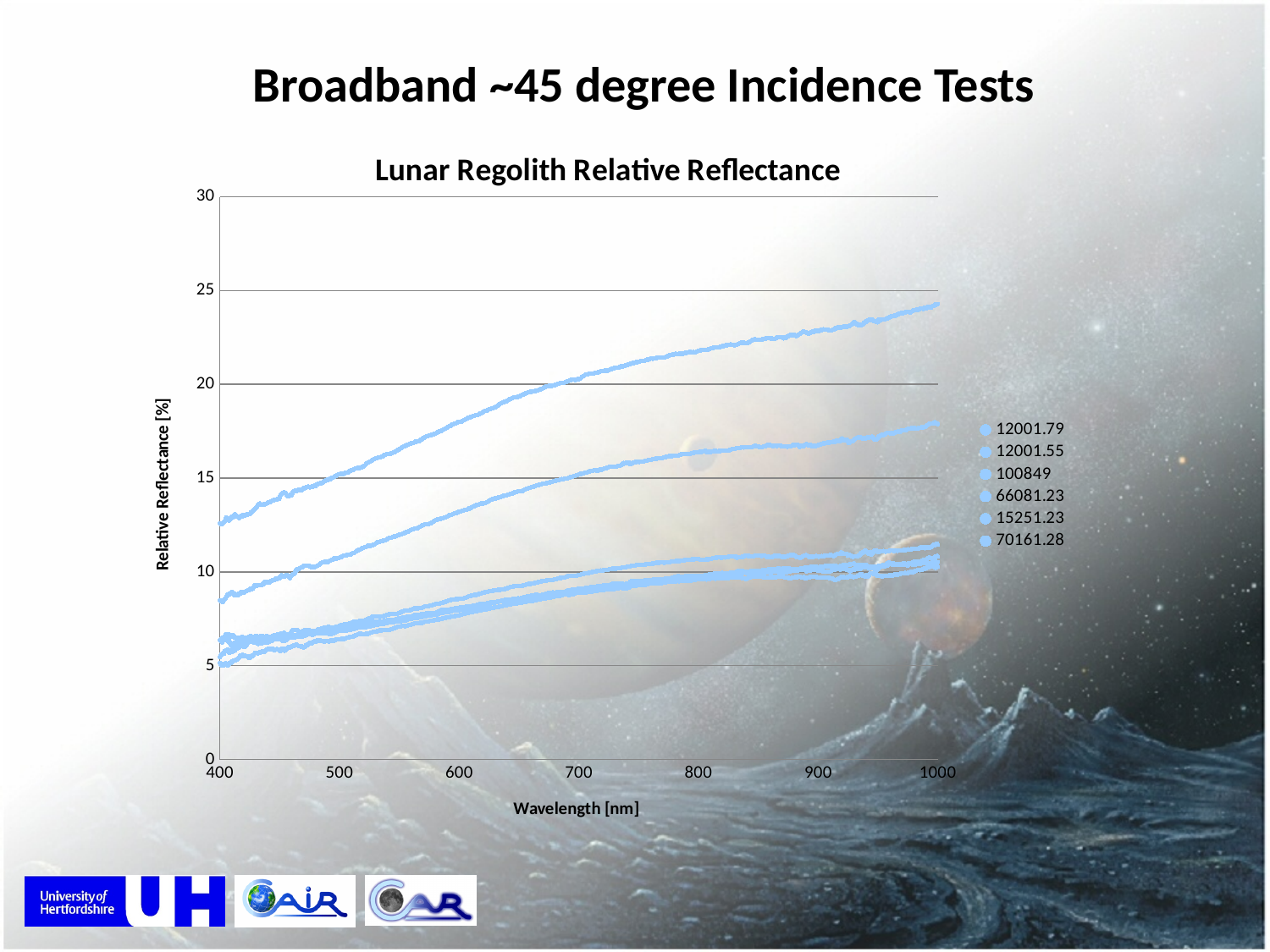
Which series is listed first in the legend? 12001.79 Is the value of the lowest curve at 1000 nm greater or less than 15? less What kind of chart is shown on the slide? line chart Is the value of the topmost curve at 400 nm greater or less than 10? greater What is the title of the chart? Lunar Regolith Relative Reflectance How many series does the legend list? 6 Is the value of the topmost curve at 1000 nm greater or less than 20? greater Do the plotted curves rise or fall as wavelength increases from 400 to 1000 nm? rise What is the label of the vertical axis? Relative Reflectance [%]